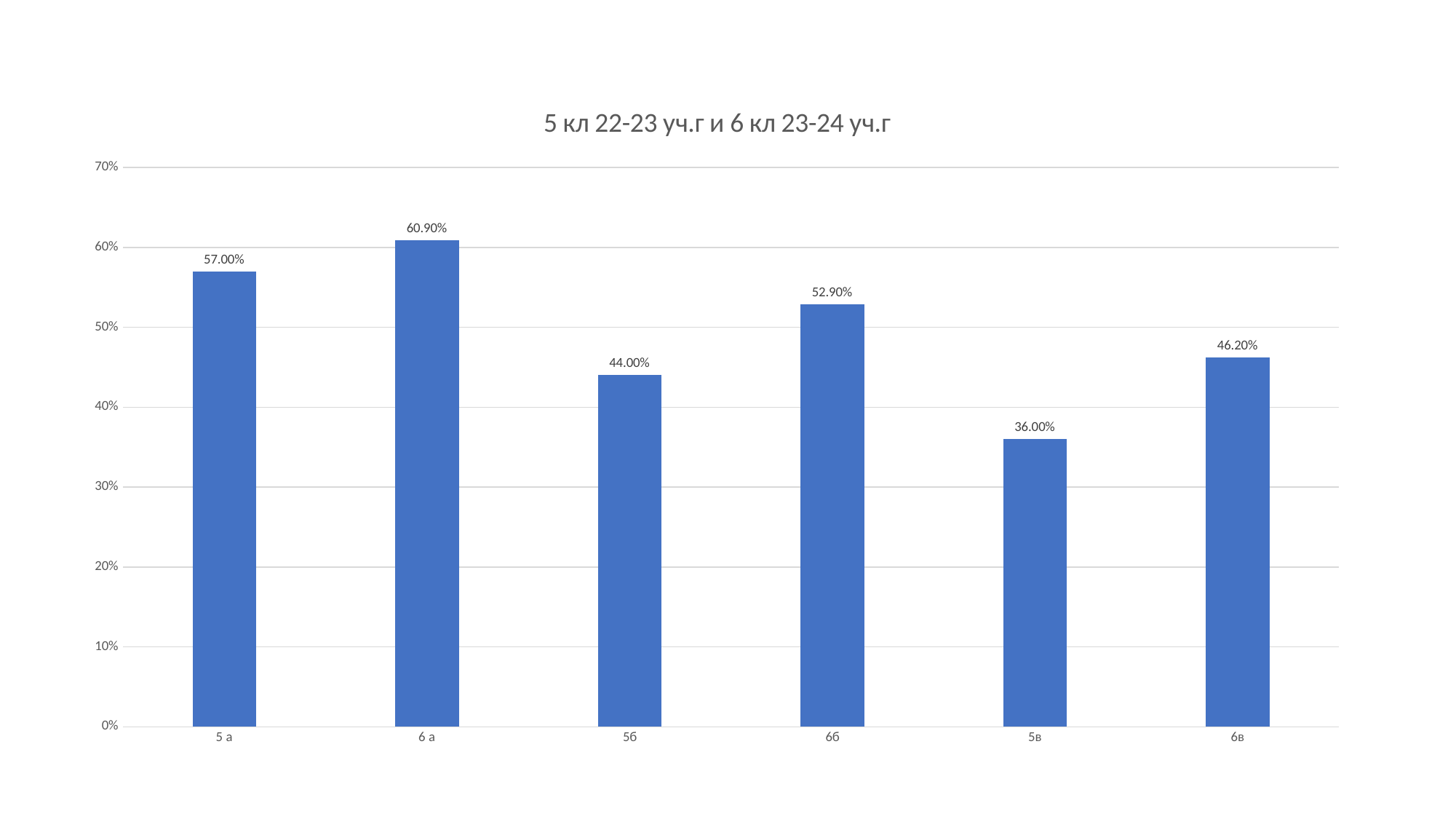
Which is larger, the value for 5б or the value for 6б? 6б What is the title of the chart? 5 кл 22-23 уч.г и 6 кл 23-24 уч.г What is the value for 5в? 36.00% How many categories are shown on the x axis? 6 What is the difference between the values for 6в and 5в? 10.20% Which category has the lowest value? 5в What is the difference between the values for 6 а and 5 а? 3.90% What is the value for 5 а? 57.00% Is the value for 6в greater or less than 40%? greater Which category has the highest value? 6 а What is the value for 6б? 52.90% What kind of chart is shown on the slide? bar chart